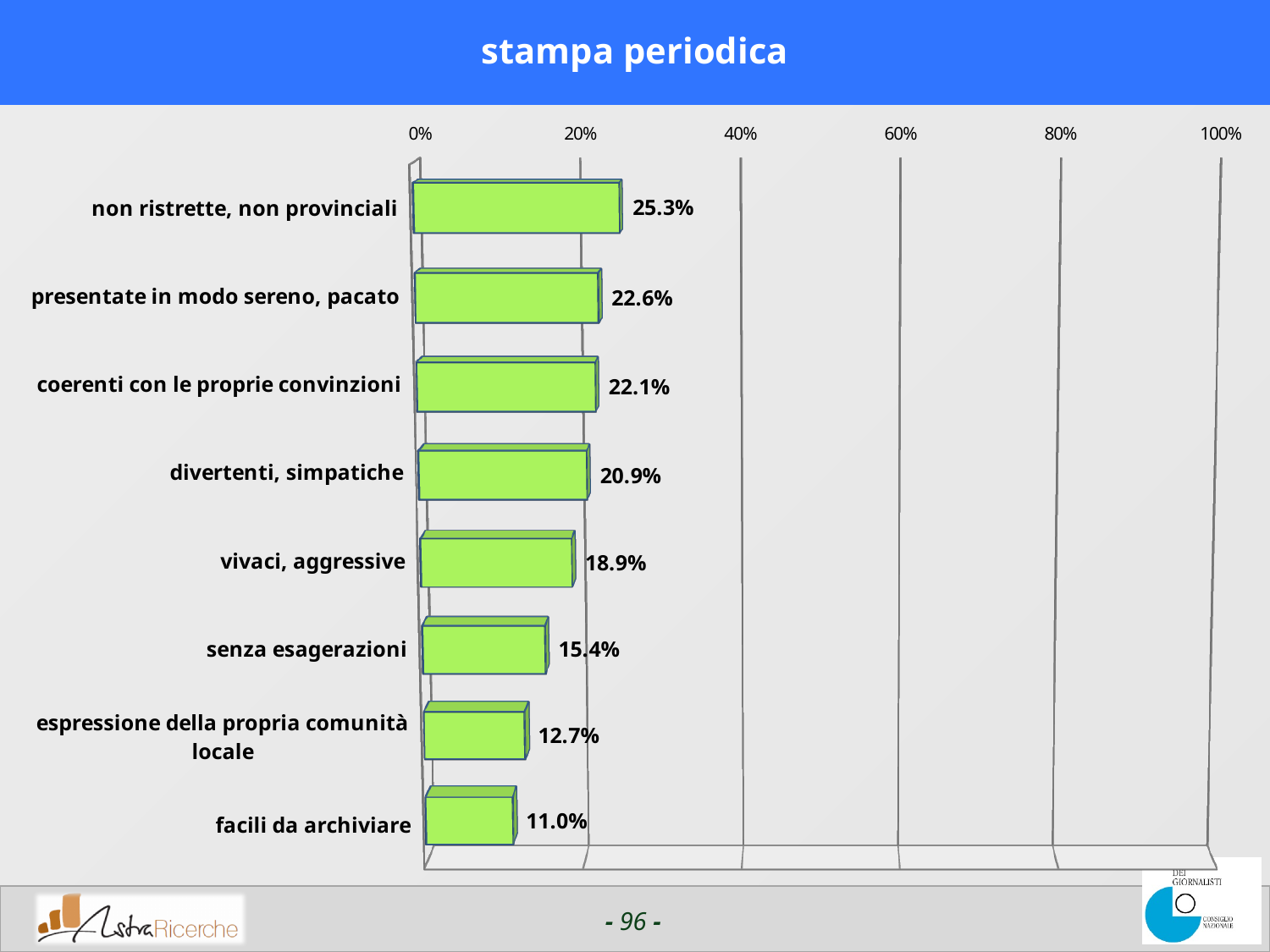
Is the value for "senza esagerazioni" greater or less than 20%? less How many categories are shown in the chart? 8 Which category has the lowest value? facili da archiviare Which category has the highest value? non ristrette, non provinciali What is the title of the chart? stampa periodica What is the value for "facili da archiviare"? 11.0% What is the difference between "presentate in modo sereno, pacato" and "senza esagerazioni"? 7.2% What kind of chart is shown on the slide? bar chart Which is larger: "vivaci, aggressive" or "espressione della propria comunità locale"? vivaci, aggressive What is the value for "non ristrette, non provinciali"? 25.3% Is the value for "coerenti con le proprie convinzioni" greater or less than 20%? greater What is the value for "divertenti, simpatiche"? 20.9%